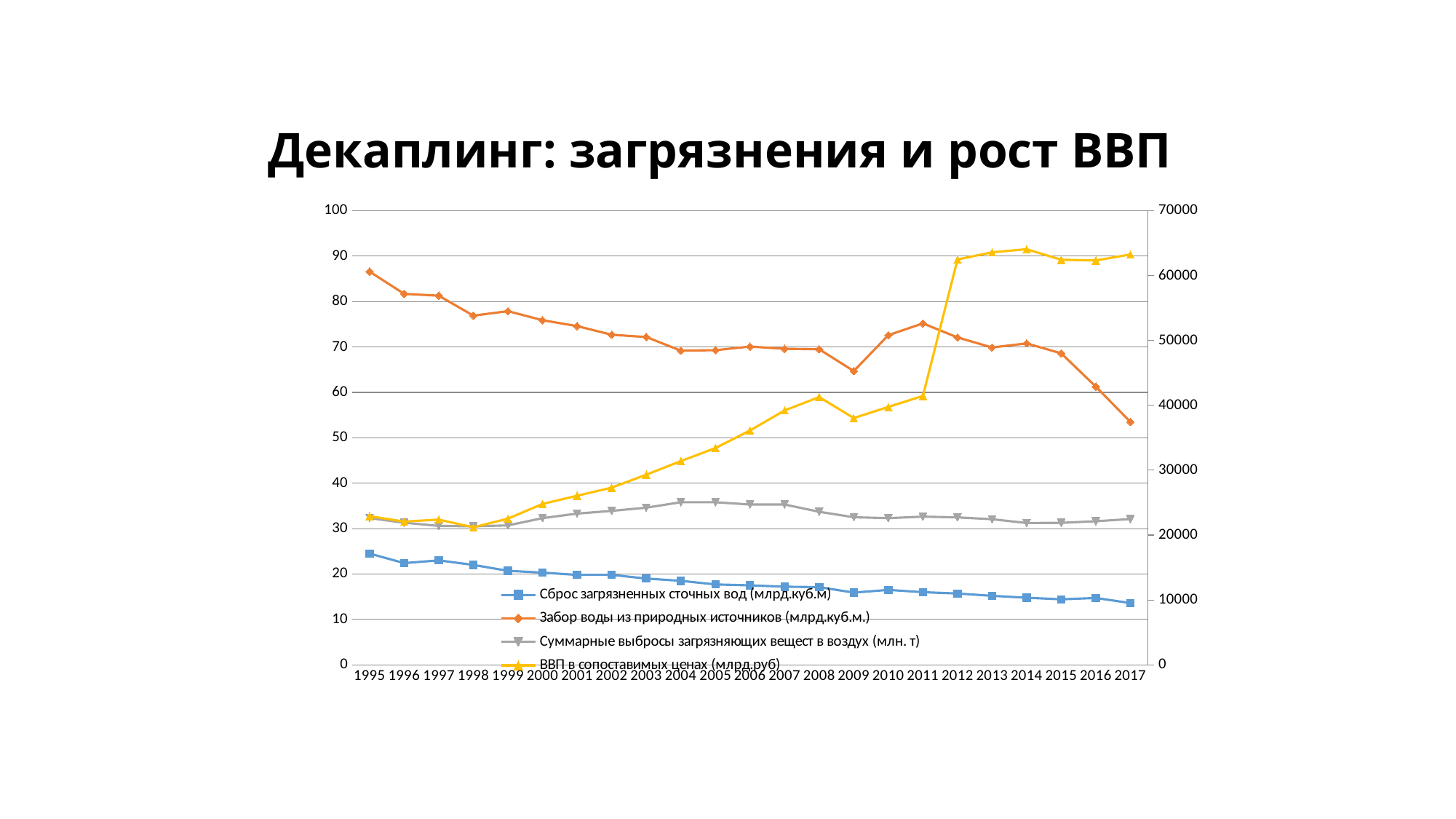
What is the title of the slide? Декаплинг: загрязнения и рост ВВП On the right axis, is the value for 'ВВП в сопоставимых ценах (млрд.руб)' in 2017 greater or less than 60000? greater How many series does the legend list? 4 In which year is the series 'Забор воды из природных источников (млрд.куб.м.)' at its highest? 1995 Does the series 'Сброс загрязненных сточных вод (млрд.куб.м)' rise or fall from 1995 to 2017? fall How many years are plotted along the x axis? 23 Which is larger for 'Сброс загрязненных сточных вод (млрд.куб.м)': the value in 1995 or in 2017? 1995 Which colour is used for the series 'ВВП в сопоставимых ценах (млрд.руб)'? yellow In which year is the series 'Забор воды из природных источников (млрд.куб.м.)' at its lowest? 2017 On the left axis, is the value for 'Сброс загрязненных сточных вод (млрд.куб.м)' in 1995 greater or less than 20? greater What kind of chart is shown on the slide? line chart Does the series 'ВВП в сопоставимых ценах (млрд.руб)' rise or fall overall from 1995 to 2017? rise